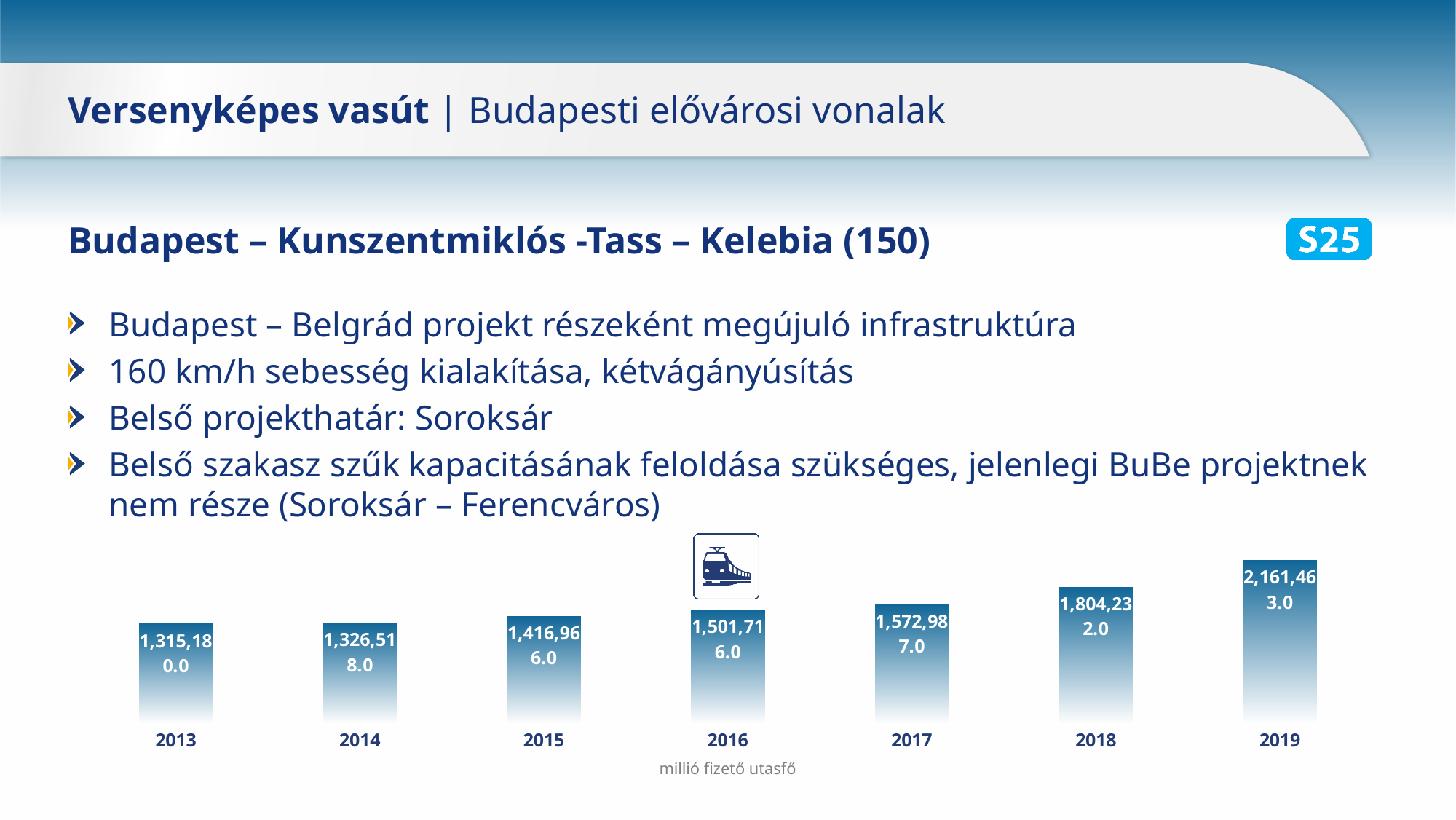
What is the difference between the values for 2018 and 2017? 231,245.0 Which is larger, the value for 2015 or the value for 2017? 2017 Do the values rise or fall from 2013 to 2019? rise What unit is given below the chart? millió fizető utasfő Which year has the lowest value? 2013 What is the value for 2019? 2,161,463.0 Which year has the highest value? 2019 What kind of chart is shown on the slide? bar chart How many years are shown on the chart? 7 What is the difference between the values for 2019 and 2018? 357,231.0 What is the value for 2013? 1,315,180.0 What is the value for 2016? 1,501,716.0